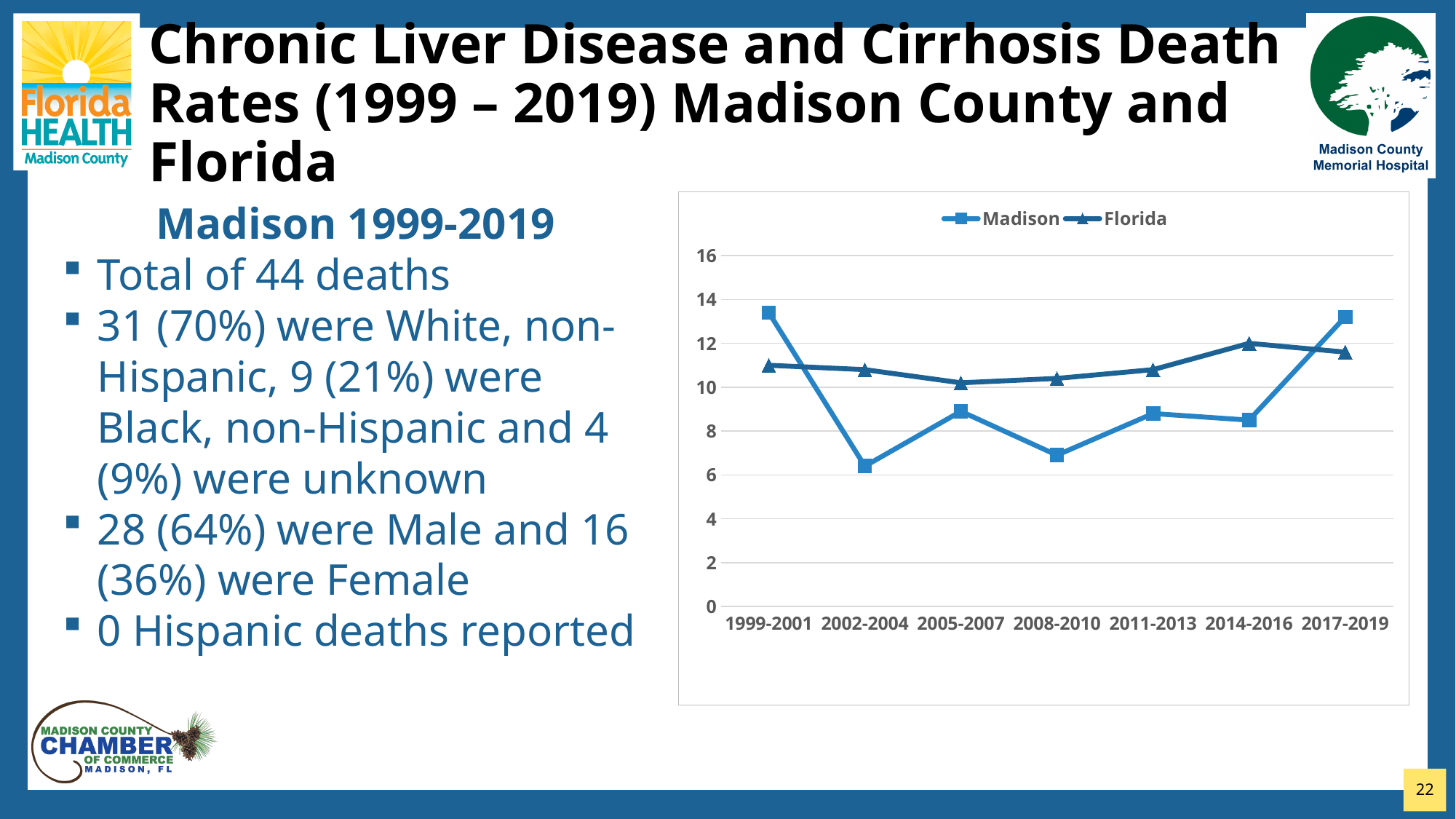
In which period does the Florida series reach its highest value? 2014-2016 In 2017-2019, which series has the higher value, Madison or Florida? Madison Is the Madison value for 2002-2004 greater or less than 8? less How many series does the chart legend list? 2 Is the Madison value for 2008-2010 greater or less than 8? less Which two series are listed in the chart legend? Madison and Florida Is the Madison value for 1999-2001 greater or less than 12? greater In 2002-2004, which series has the higher value, Madison or Florida? Florida What kind of chart is shown on the slide? Line chart Does the Madison series rise or fall from 2014-2016 to 2017-2019? Rise How many time periods are plotted along the x axis of the chart? 7